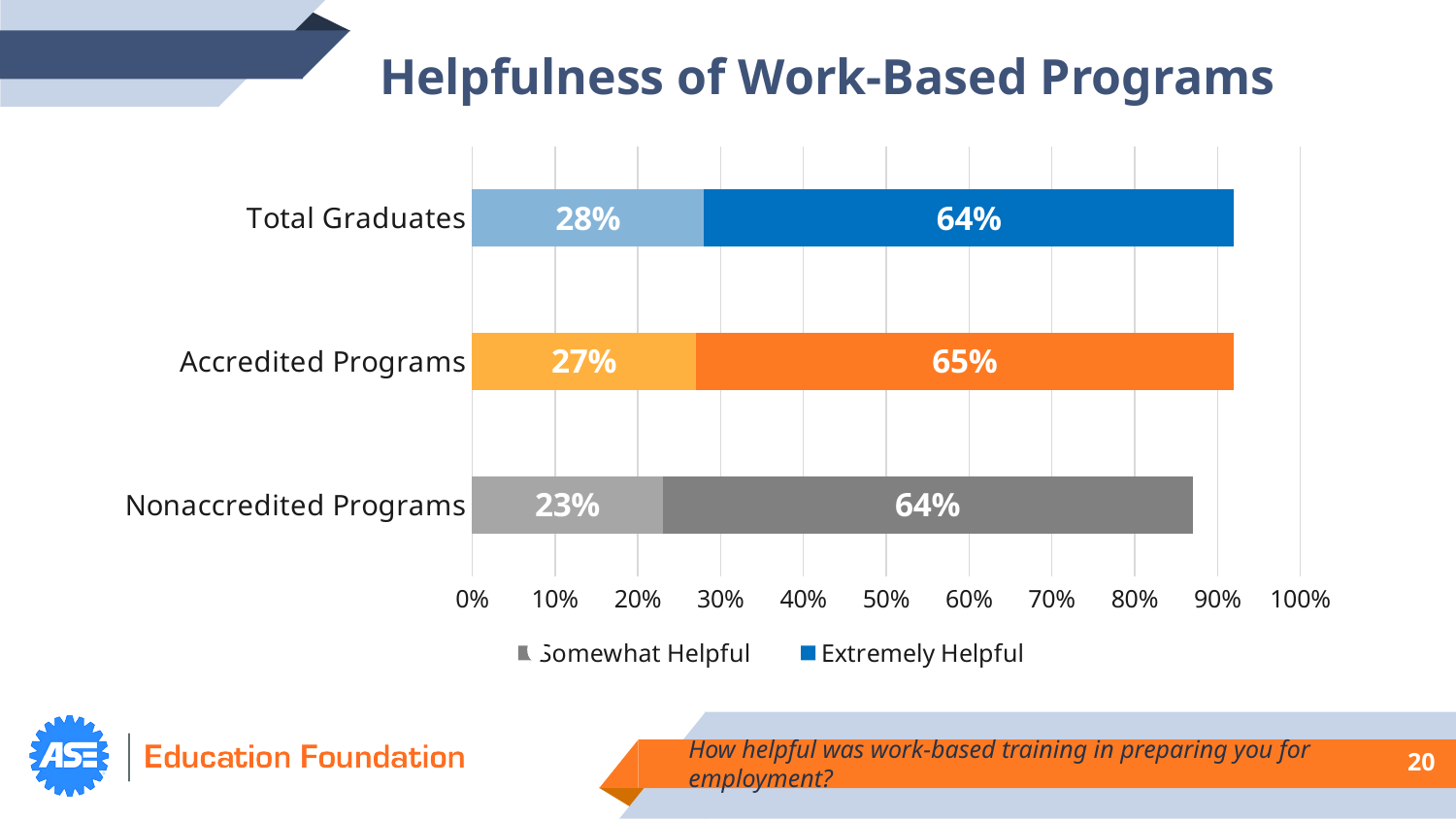
What percentage of Total Graduates found work-based programs Extremely Helpful? 64% What is the Somewhat Helpful value for Nonaccredited Programs? 23% Which category has the lowest Somewhat Helpful value? Nonaccredited Programs How many series does the legend list? 2 What type of chart is shown on the slide? Stacked bar chart What is the combined total of Somewhat Helpful and Extremely Helpful for Accredited Programs? 92% How many categories are shown on the chart? 3 What is the difference between the Somewhat Helpful values for Total Graduates and Nonaccredited Programs? 5% What is the Somewhat Helpful value for Accredited Programs? 27% What is the combined total of Somewhat Helpful and Extremely Helpful for Nonaccredited Programs? 87% What is the Extremely Helpful value for Accredited Programs? 65% Which category has the highest Somewhat Helpful value? Total Graduates